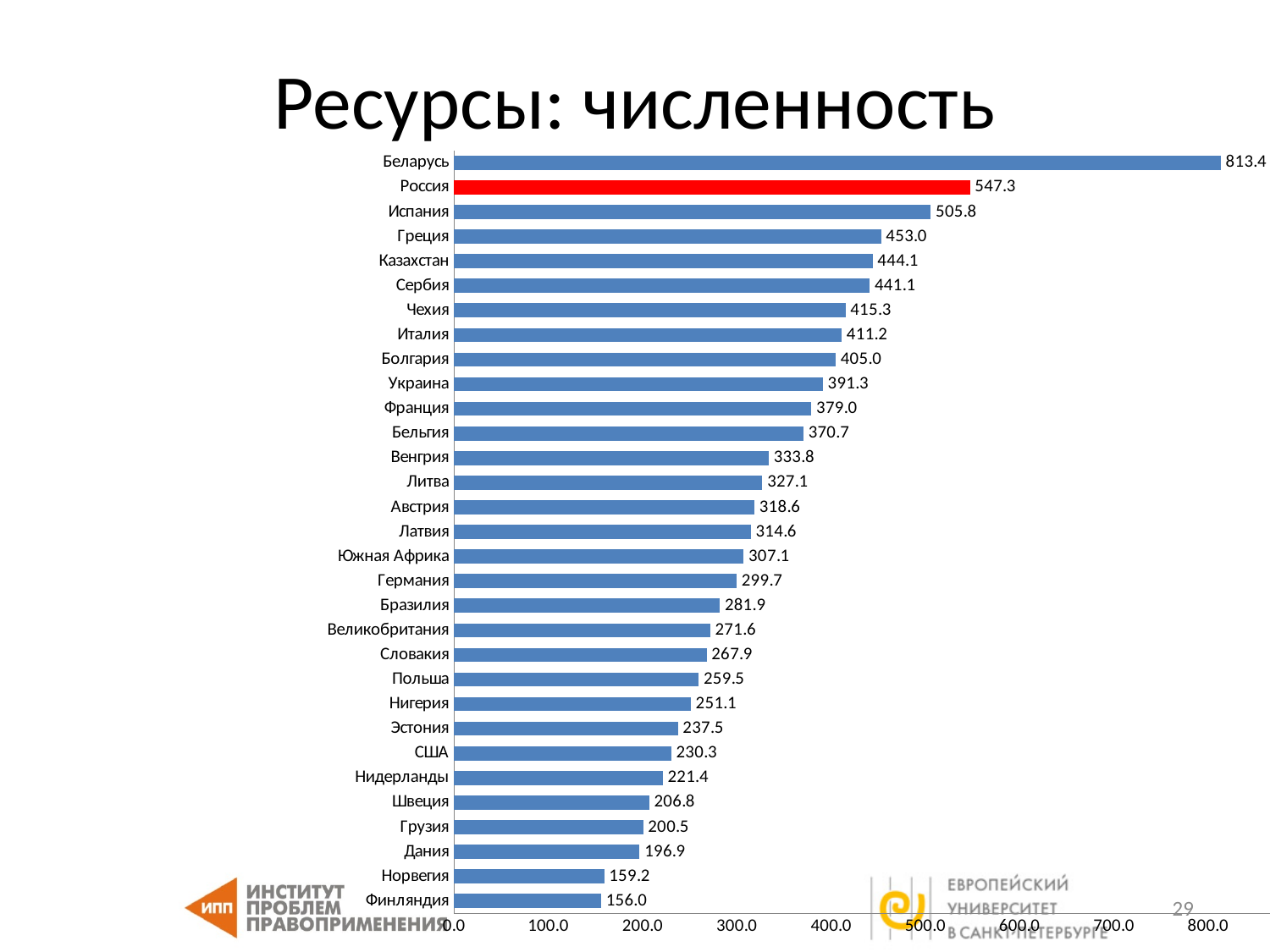
Which is larger, the value for Украина or the value for Франция? Украина What is the difference between the values for Испания and Греция? 52.8 Is the value for Чехия greater or less than 400? greater Which category has the highest value? Беларусь What kind of chart is shown on the slide? bar chart What is the value for Германия? 299.7 Which bar is highlighted in red? Россия What is the value for США? 230.3 How many categories are shown in the chart? 31 Which category has the lowest value? Финляндия What is the value for Россия? 547.3 What is the difference between the values for Беларусь and Россия? 266.1